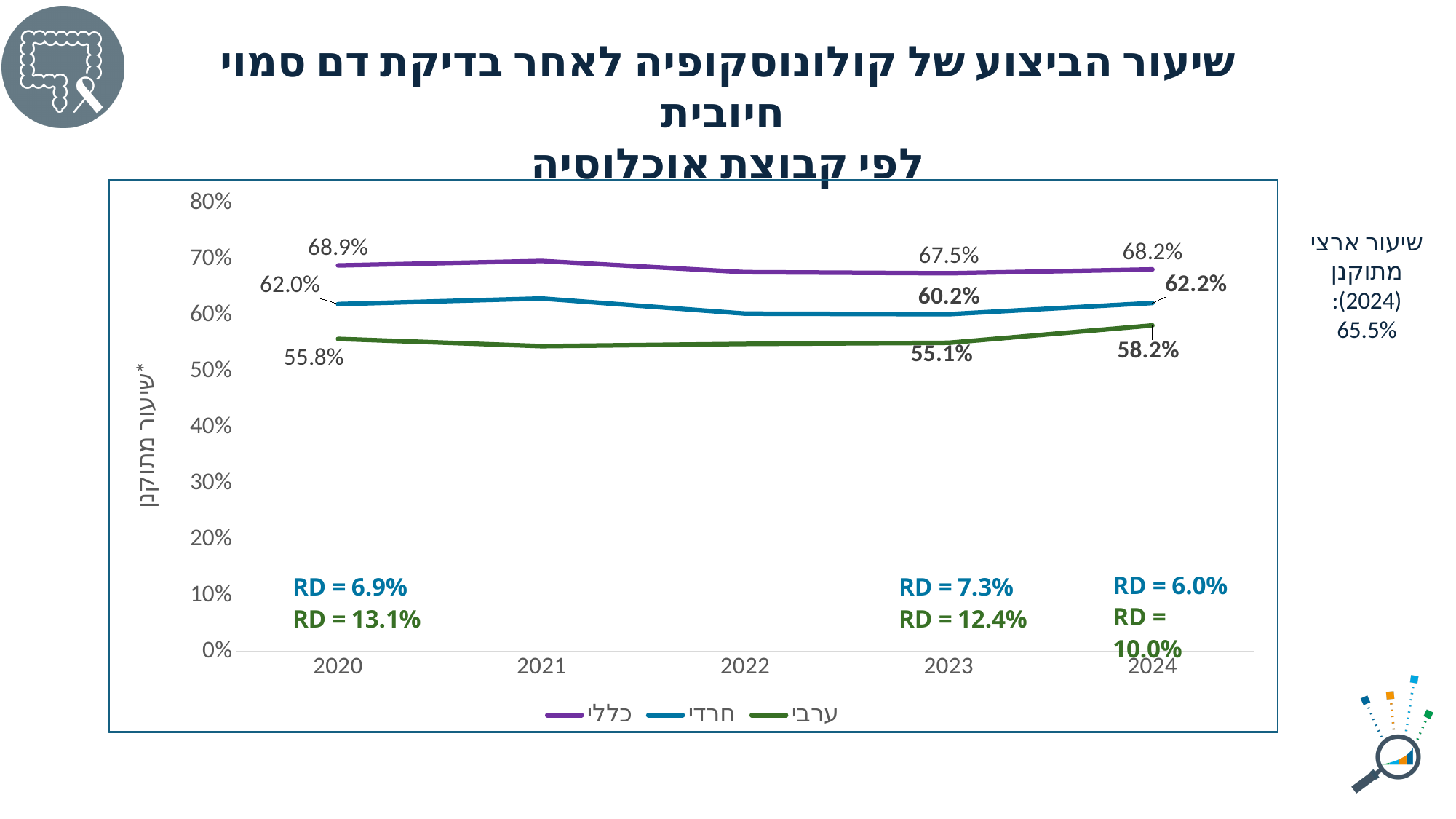
What is the value for the חרדי series in 2024? 62.2% How many series does the legend list? 3 What is the value for the ערבי series in 2023? 55.1% Which series has the highest value in 2023? כללי Is the value for the ערבי series in 2021 greater or less than 60%? less What is the value for the כללי series in 2020? 68.9% What kind of chart is shown on the slide? line chart How many years are shown on the x axis? 5 Which series has the lowest value in 2024? ערבי What is the national adjusted rate (שיעור ארצי מתוקנן) for 2024 shown beside the chart? 65.5% What is the difference between the כללי and ערבי values in 2020? 13.1% Which is larger, the חרדי value in 2020 or the חרדי value in 2024? 2024